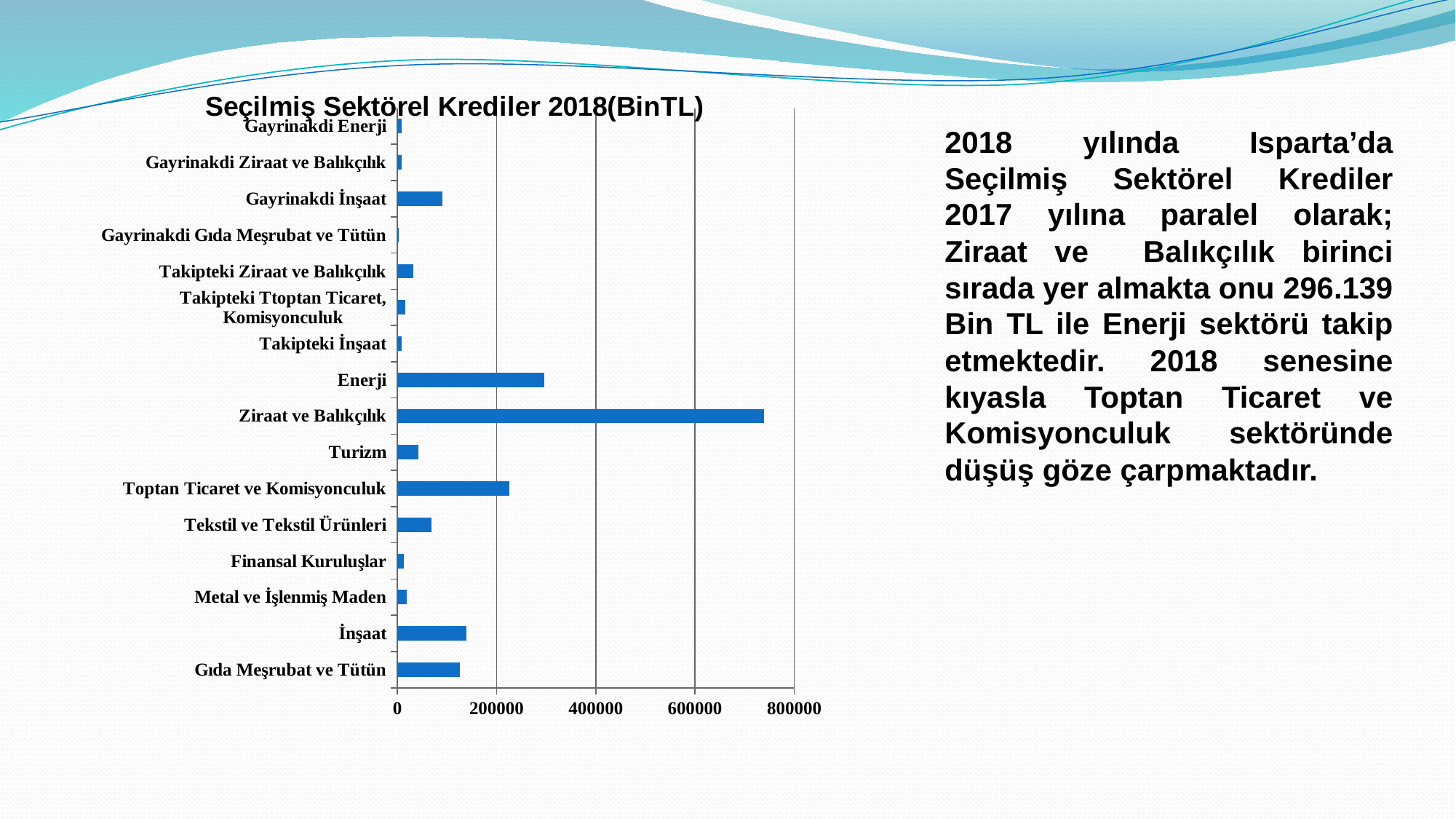
Is the value for Enerji greater or less than 200000? greater Which is larger, the value for Gayrinakdi İnşaat or the value for Takipteki Ziraat ve Balıkçılık? Gayrinakdi İnşaat Which is larger, the value for Enerji or the value for Toptan Ticaret ve Komisyonculuk? Enerji What kind of chart is shown on the slide? bar chart What is the title of the chart? Seçilmiş Sektörel Krediler 2018(BinTL) Is the value for Toptan Ticaret ve Komisyonculuk greater or less than 400000? less Which is larger, the value for İnşaat or the value for Turizm? İnşaat Which category has the lowest value in the chart? Gayrinakdi Gıda Meşrubat ve Tütün Is the value for İnşaat greater or less than 200000? less Which category has the highest value in the chart? Ziraat ve Balıkçılık How many categories are plotted in the chart? 16